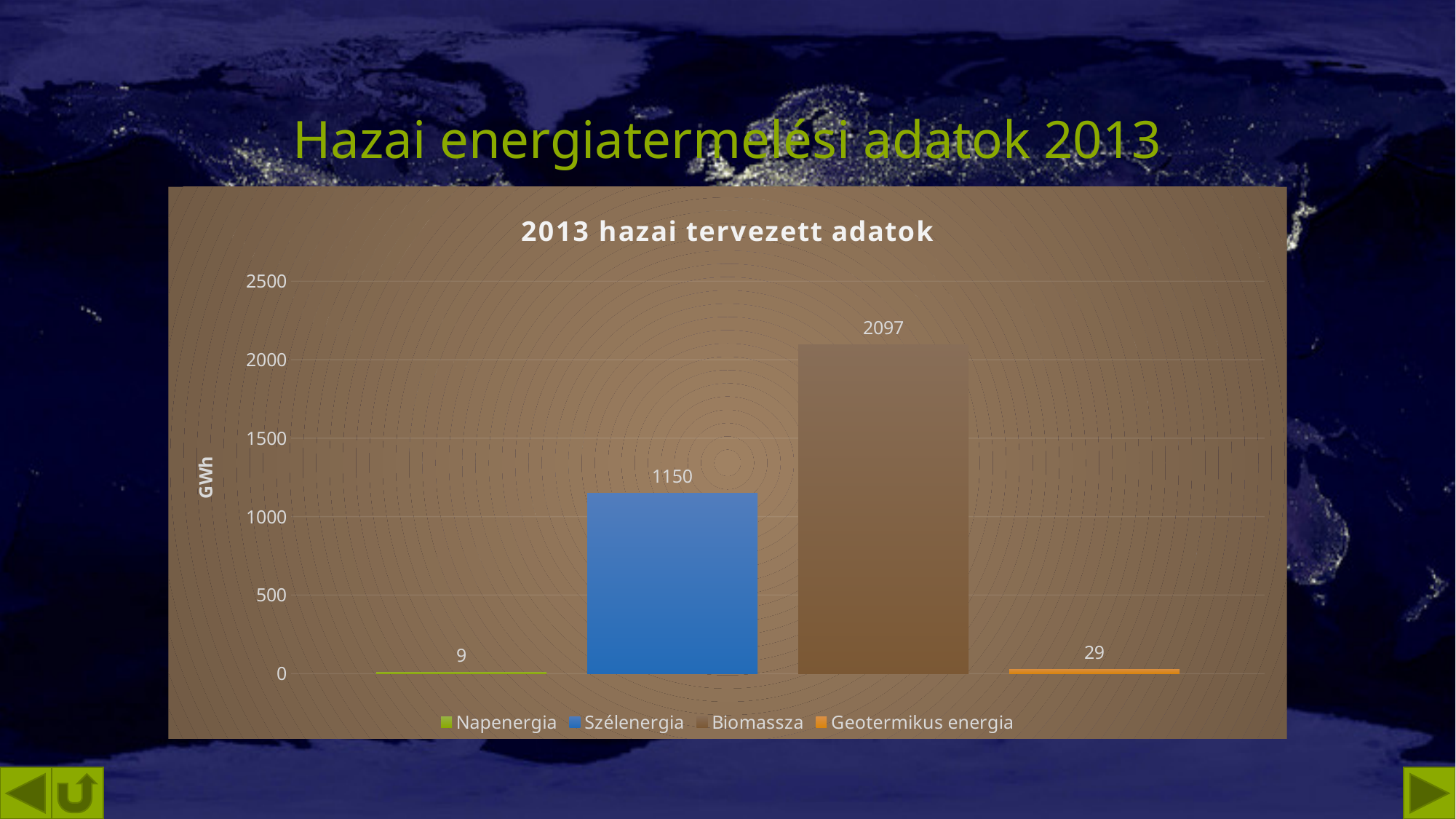
What is the title of the chart? 2013 hazai tervezett adatok What kind of chart is shown on the slide? bar chart What is the difference between the values for Biomassza and Szélenergia? 947 Which energy source has the highest value? Biomassza What is the value for Geotermikus energia? 29 Which energy source has the lowest value? Napenergia What is the value for Napenergia? 9 Is the value for Biomassza greater or less than 2000? greater What is the value for Biomassza? 2097 How many energy sources are shown in the chart? 4 Which is larger, the value for Geotermikus energia or the value for Napenergia? Geotermikus energia What is the value for Szélenergia? 1150